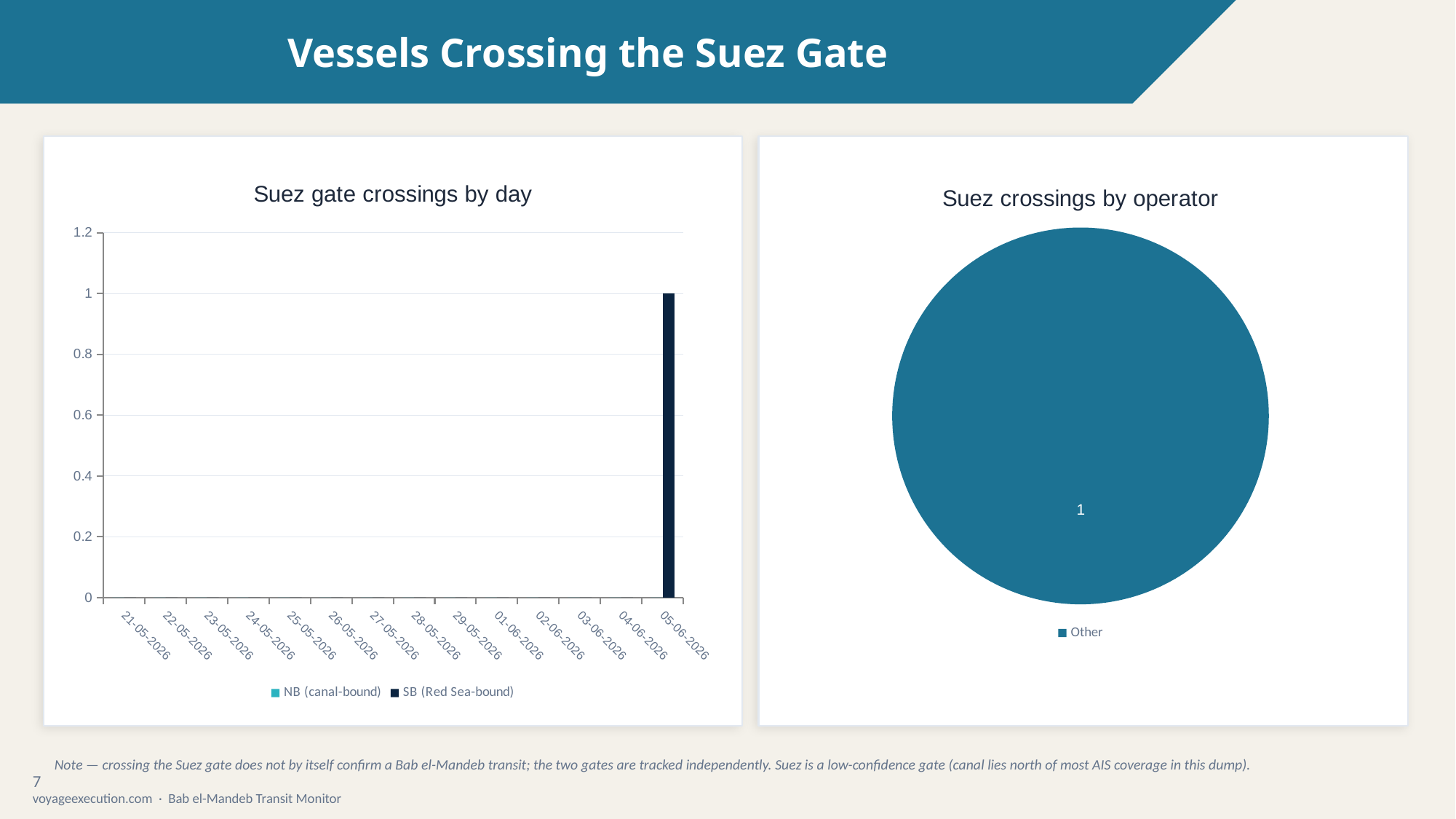
What kind of chart is "Suez gate crossings by day"? bar chart In "Suez gate crossings by day", what are the two legend entries? NB (canal-bound) and SB (Red Sea-bound) In "Suez gate crossings by day", how many series does the legend list? 2 What kind of chart is "Suez crossings by operator"? pie chart In "Suez crossings by operator", how many slices does the pie have? 1 In "Suez crossings by operator", what is the only legend entry? Other In "Suez gate crossings by day", how many dates are shown on the x axis? 14 In "Suez crossings by operator", what share of the pie does Other represent? 100% In "Suez gate crossings by day", what is the SB (Red Sea-bound) value on 05-06-2026? 1 In "Suez crossings by operator", what value is labelled on the Other slice? 1 In "Suez gate crossings by day", is the SB (Red Sea-bound) value on 05-06-2026 greater or less than 0.6? greater In "Suez gate crossings by day", which date has the highest SB (Red Sea-bound) value? 05-06-2026